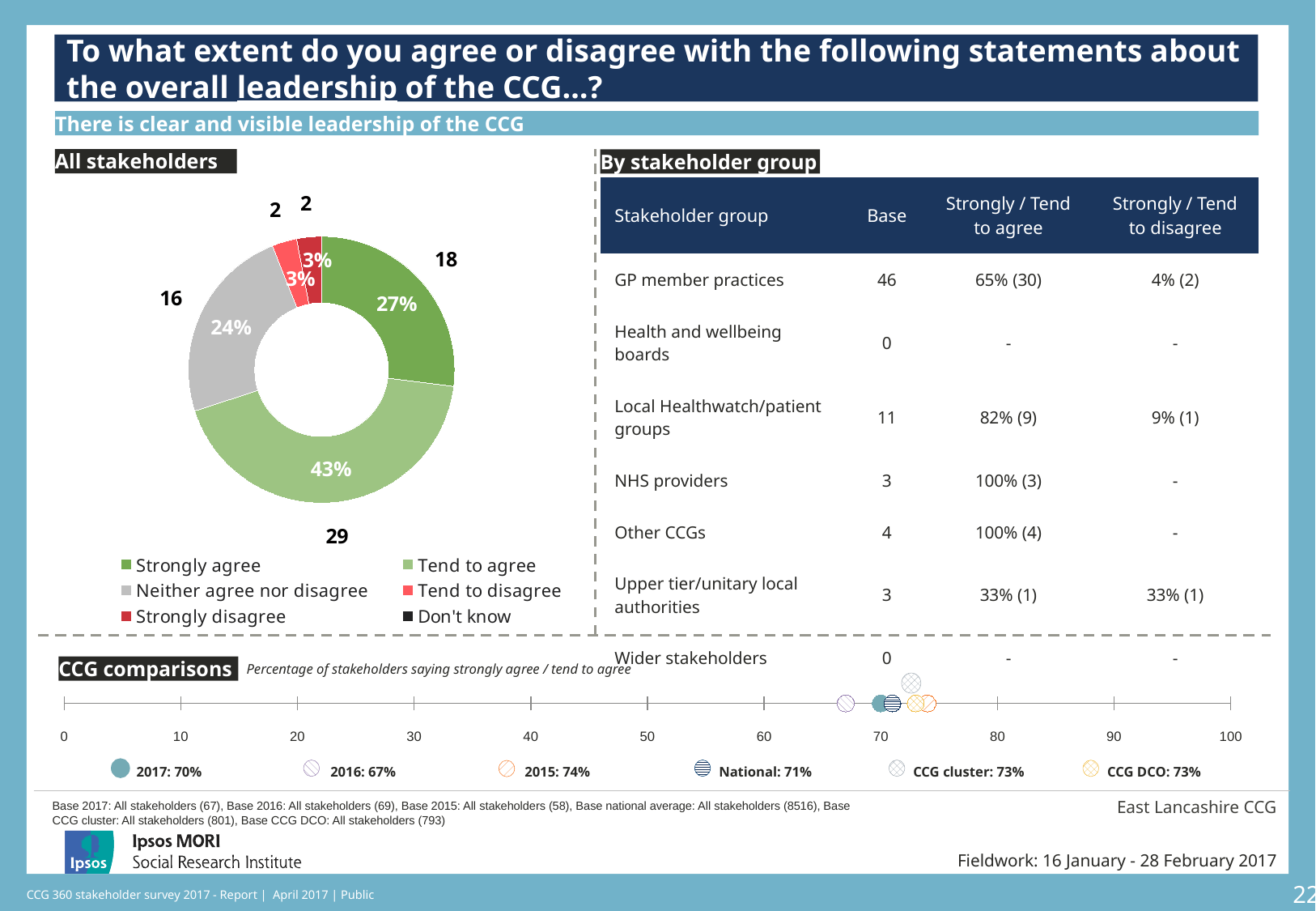
In the 'All stakeholders' donut chart, what percentage of stakeholders tend to agree? 43% What type of chart is used for the 'All stakeholders' section? Donut (pie) chart In the 'All stakeholders' donut chart, how many stakeholders (count) tend to agree? 29 In the 'All stakeholders' donut chart, what is the difference in percentage points between 'Tend to agree' and 'Strongly agree'? 16 In the 'CCG comparisons' chart, what is the difference between the 2017 value and the 2016 value? 3 percentage points In the 'All stakeholders' donut chart, which is larger: the share for 'Neither agree nor disagree' or the share for 'Strongly agree'? Strongly agree In the 'CCG comparisons' chart, which year has the highest percentage: 2015, 2016 or 2017? 2015 In the 'All stakeholders' donut chart, what percentage of stakeholders strongly agree? 27% In the 'All stakeholders' donut chart, which response category has the largest share? Tend to agree How many entries does the legend of the 'All stakeholders' donut chart list? 6 In the 'All stakeholders' donut chart, what percentage neither agree nor disagree? 24% In the 'CCG comparisons' chart, what is the 2017 percentage of stakeholders saying strongly agree / tend to agree? 70%